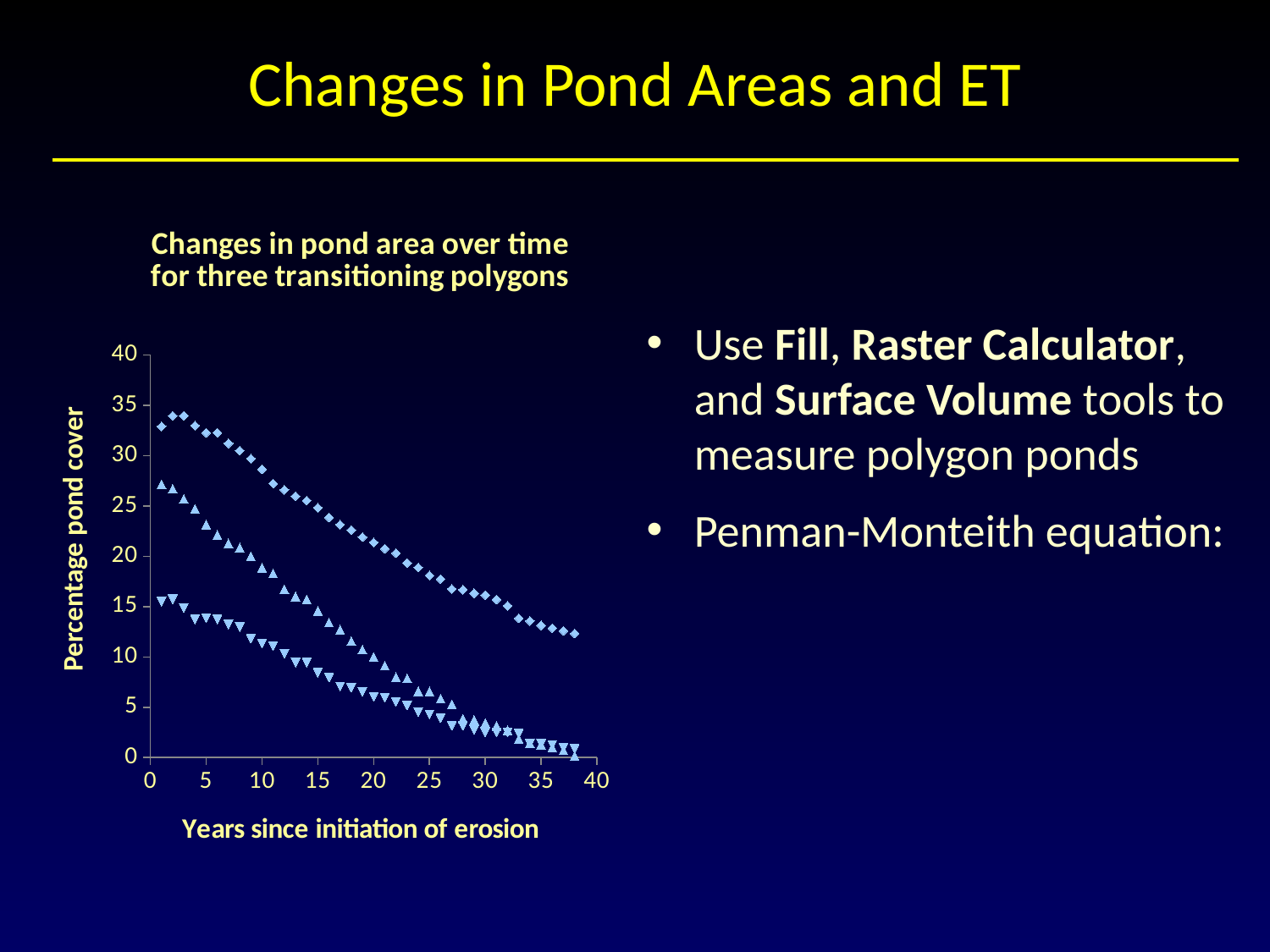
Is the final value of the lowest series (near year 38) greater or less than 5? less How many series (polygons) are plotted on the chart? 3 What is the title of the chart? Changes in pond area over time for three transitioning polygons What is the label of the x axis of the chart? Years since initiation of erosion Is the starting value of the middle series (at year 0) greater or less than 25? greater What is the maximum value shown on the y axis of the chart? 40 Is the final value of the highest series (near year 38) greater or less than 10? greater Do the values of the series rise or fall as years since initiation of erosion increase? Fall What kind of chart is shown on the slide? Scatter plot